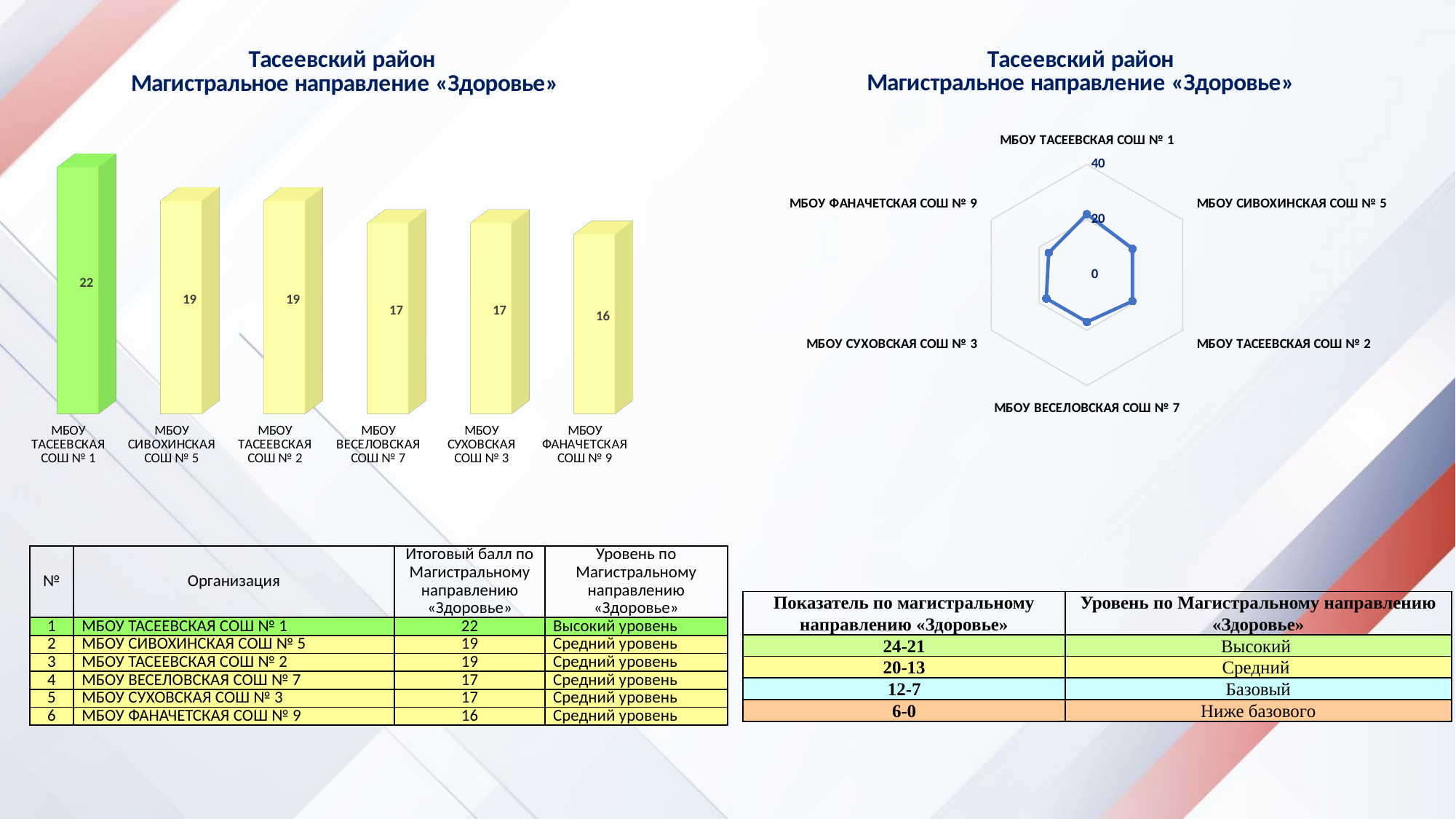
What kind of chart is shown on the left side of the slide? Bar chart On the bar chart on the left, which category has the highest value? МБОУ ТАСЕЕВСКАЯ СОШ № 1 On the bar chart on the left, which is larger: the value for МБОУ СИВОХИНСКАЯ СОШ № 5 or the value for МБОУ СУХОВСКАЯ СОШ № 3? МБОУ СИВОХИНСКАЯ СОШ № 5 On the bar chart on the left, what is the value for МБОУ ВЕСЕЛОВСКАЯ СОШ № 7? 17 On the bar chart on the left, what is the difference between the values for МБОУ ТАСЕЕВСКАЯ СОШ № 1 and МБОУ ФАНАЧЕТСКАЯ СОШ № 9? 6 On the bar chart on the left, what is the value for МБОУ ТАСЕЕВСКАЯ СОШ № 1? 22 On the bar chart on the left, which bar is coloured green rather than yellow? МБОУ ТАСЕЕВСКАЯ СОШ № 1 How many bars are shown on the bar chart on the left? 6 On the radar chart on the right, is the value for МБОУ ТАСЕЕВСКАЯ СОШ № 2 greater or less than 40? less On the bar chart on the left, what is the value for МБОУ ФАНАЧЕТСКАЯ СОШ № 9? 16 What kind of chart is shown on the right side of the slide? Radar chart On the bar chart on the left, which category has the lowest value? МБОУ ФАНАЧЕТСКАЯ СОШ № 9